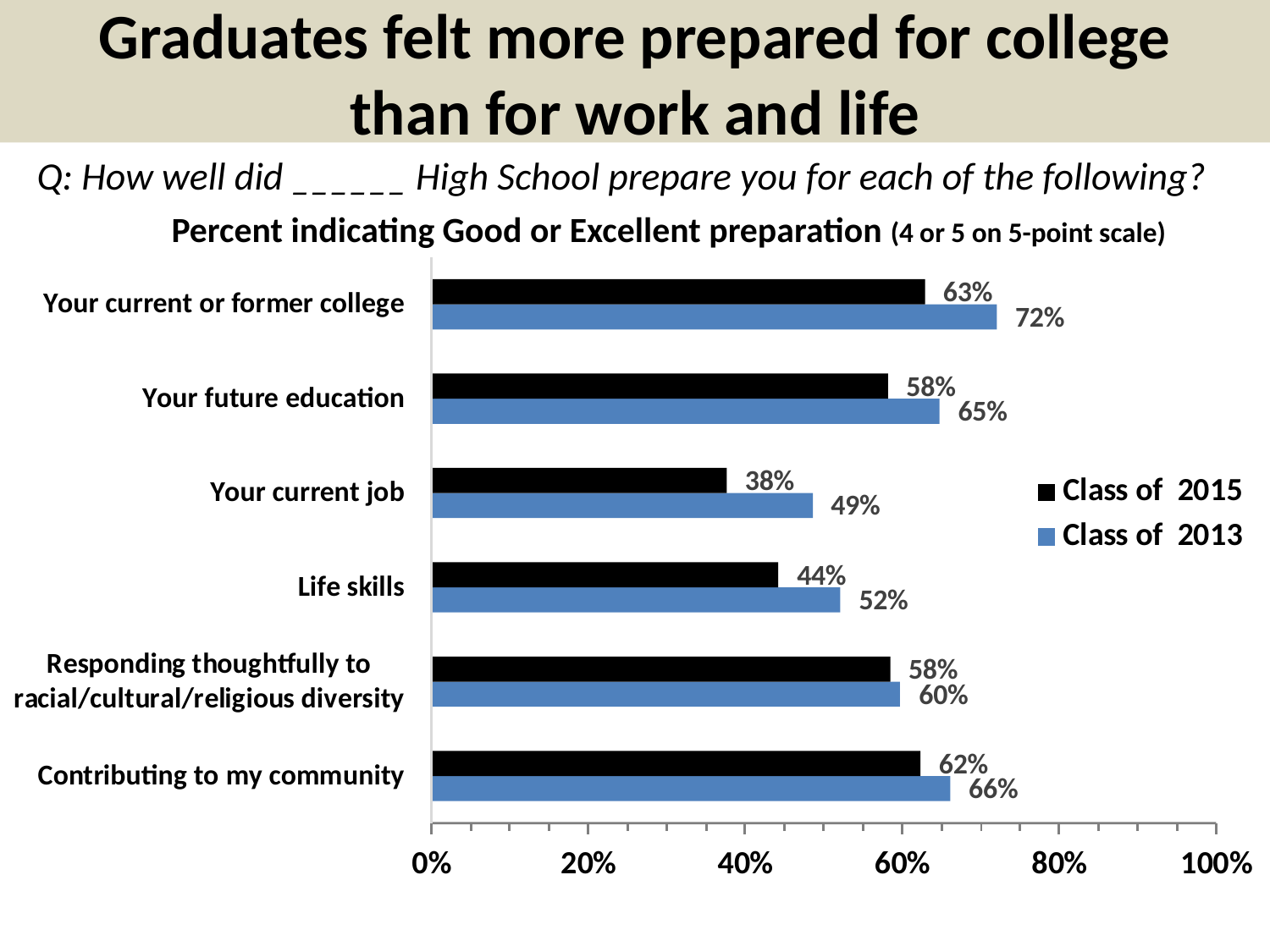
Is the Class of 2015 value for 'Life skills' greater or less than 60%? less Which category has the lowest value for the Class of 2015? Your current job What kind of chart is shown on the slide? Bar chart For 'Contributing to my community', which class has the larger value, Class of 2015 or Class of 2013? Class of 2013 Which category has the highest value for the Class of 2013? Your current or former college What percent of the Class of 2013 indicated Good or Excellent preparation for 'Your current job'? 49% What percent of the Class of 2015 indicated Good or Excellent preparation for 'Your current or former college'? 63% How many categories are shown on the chart? 6 What is the Class of 2013 value for 'Life skills'? 52% What is the difference between the Class of 2013 and Class of 2015 values for 'Your current job'? 11% How many series does the legend list? 2 What is the difference between the Class of 2013 and Class of 2015 values for 'Your current or former college'? 9%